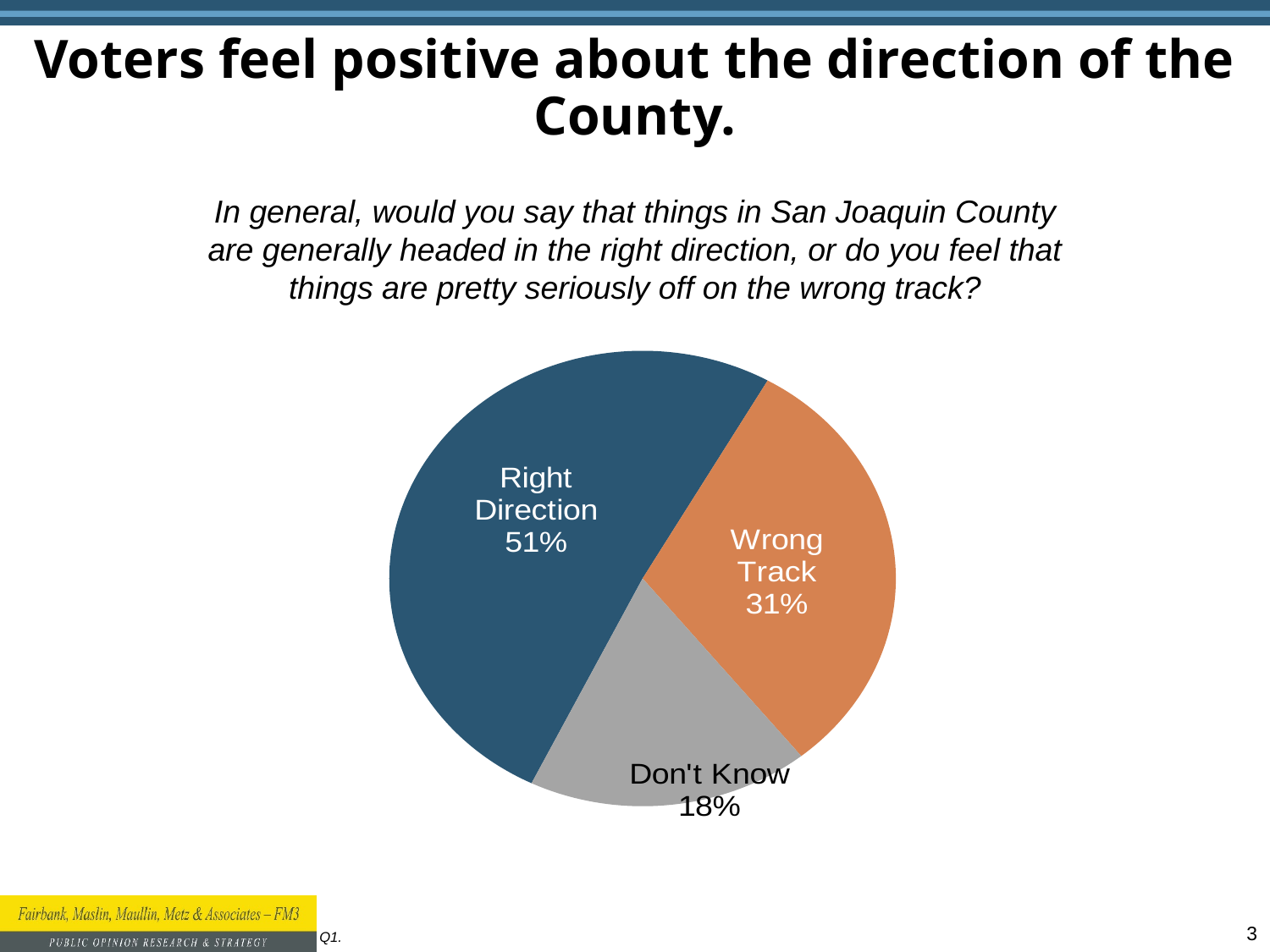
Which response has the largest share of the pie? Right Direction What kind of chart is shown on the slide? Pie chart Which is larger, the Wrong Track share or the Don't Know share? Wrong Track What percentage of voters said things are on the Wrong Track? 31% What share of the pie does the Right Direction slice represent? 51% What percentage of voters said the County is headed in the Right Direction? 51% What percentage of voters answered Don't Know? 18% What colour is the Wrong Track slice? Orange What is the difference in percentage points between Right Direction and Wrong Track? 20 How many slices does the pie chart have? 3 Which response has the smallest share of the pie? Don't Know What is the difference in percentage points between Wrong Track and Don't Know? 13